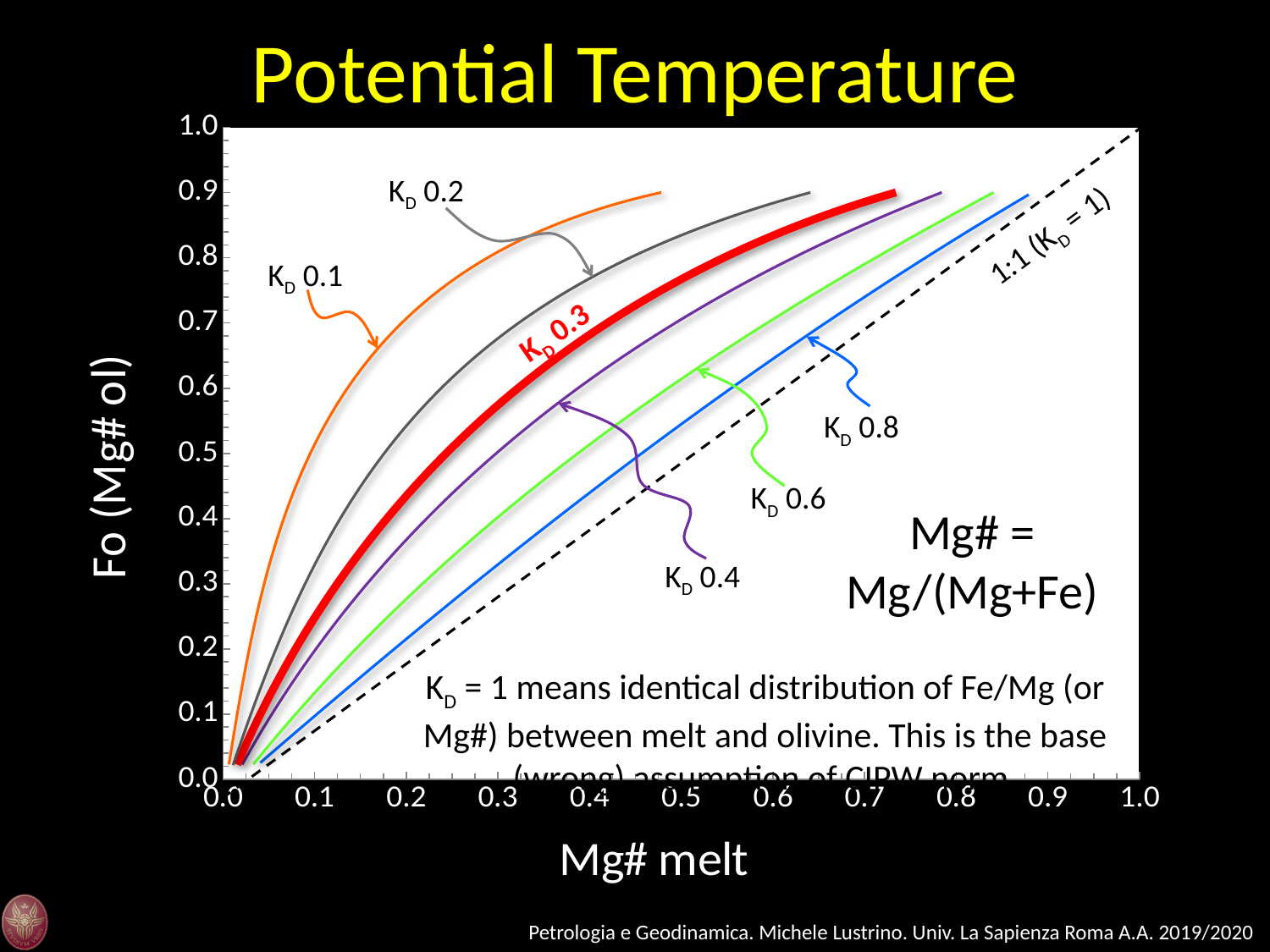
At Mg# melt = 0.6, which curve gives a higher Fo value, K_D 0.4 or K_D 0.6? K_D 0.4 What is the label of the x axis of the chart? Mg# melt Which line lies lowest on the chart (smallest Fo for a given Mg# melt)? 1:1 (K_D = 1) What colour is the K_D 0.3 curve drawn in? Red Is the Fo value of the K_D 0.1 curve at Mg# melt = 0.2 greater or less than 0.5? greater At Mg# melt = 0.4, which curve gives a higher Fo value, K_D 0.2 or K_D 0.8? K_D 0.2 Do the curves rise or fall as Mg# melt increases along the x axis? Rise Which curve lies highest on the chart (largest Fo for a given Mg# melt)? K_D 0.1 What kind of chart is shown on the slide? Line chart How many curves (including the dashed 1:1 line) are plotted on the chart? 7 Is the Fo value of the K_D 0.3 curve at Mg# melt = 0.3 greater or less than 0.5? greater Is the Fo value of the K_D 0.6 curve at Mg# melt = 0.2 greater or less than 0.5? less